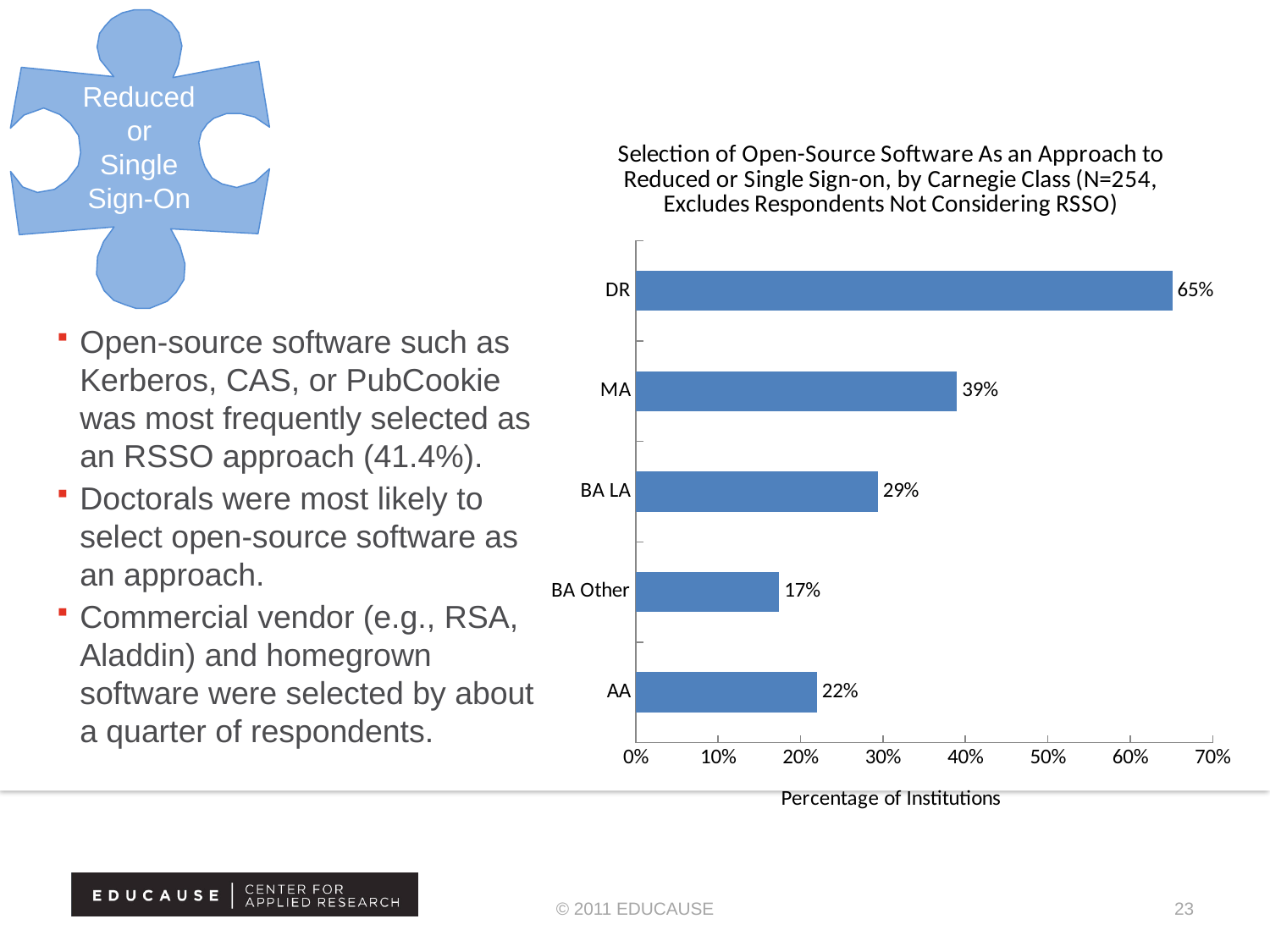
What is the value shown for BA Other institutions? 17% Which Carnegie class has the highest percentage of institutions selecting open-source software? DR Is the value for MA greater or less than 40%? less What percentage of DR institutions selected open-source software as an approach to RSSO? 65% What is the difference in percentage points between DR and MA? 26 percentage points What is the value shown for MA institutions? 39% Which is larger, the value for BA LA or the value for AA? BA LA Which Carnegie class has the lowest percentage of institutions selecting open-source software? BA Other What is the label of the horizontal axis of the chart? Percentage of Institutions How many Carnegie classes are shown in the chart? 5 What type of chart is shown on the slide? Bar chart What is the value shown for AA institutions? 22%